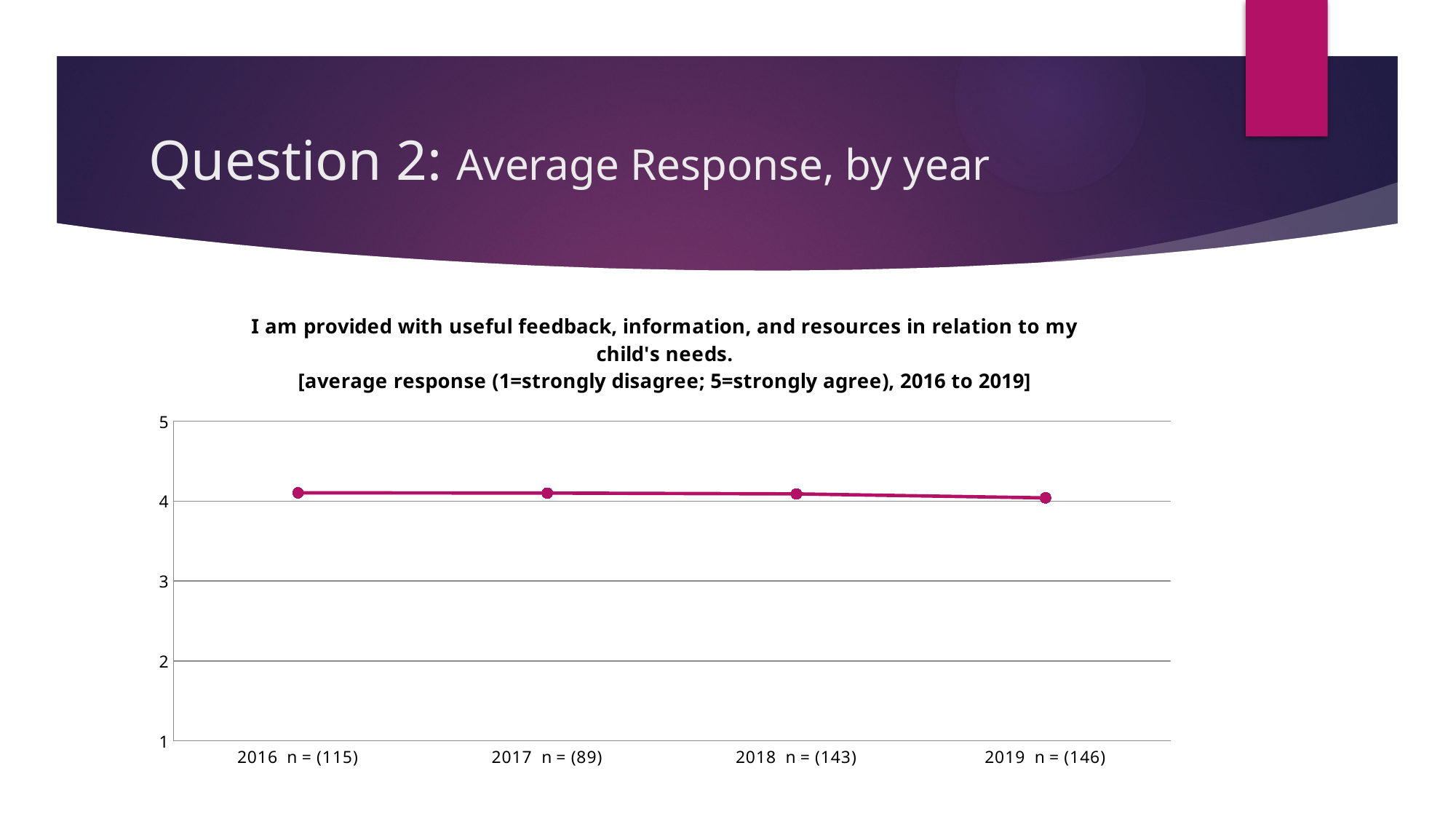
Is the average response for 2017 greater or less than 4? greater What kind of chart is shown on the slide? Line chart What is the lowest value shown on the y axis? 1 Is the average response for 2016 greater or less than 3? greater Which is larger, the average response for 2016 or for 2019? 2016 Which years are shown on the x axis of the chart? 2016, 2017, 2018, 2019 Is the average response for 2019 greater or less than 5? less Which year has the lowest average response? 2019 Do the average responses rise or fall from 2016 to 2019? Fall slightly What is the sample size (n) shown for 2017? 89 How many data points are plotted on the line? 4